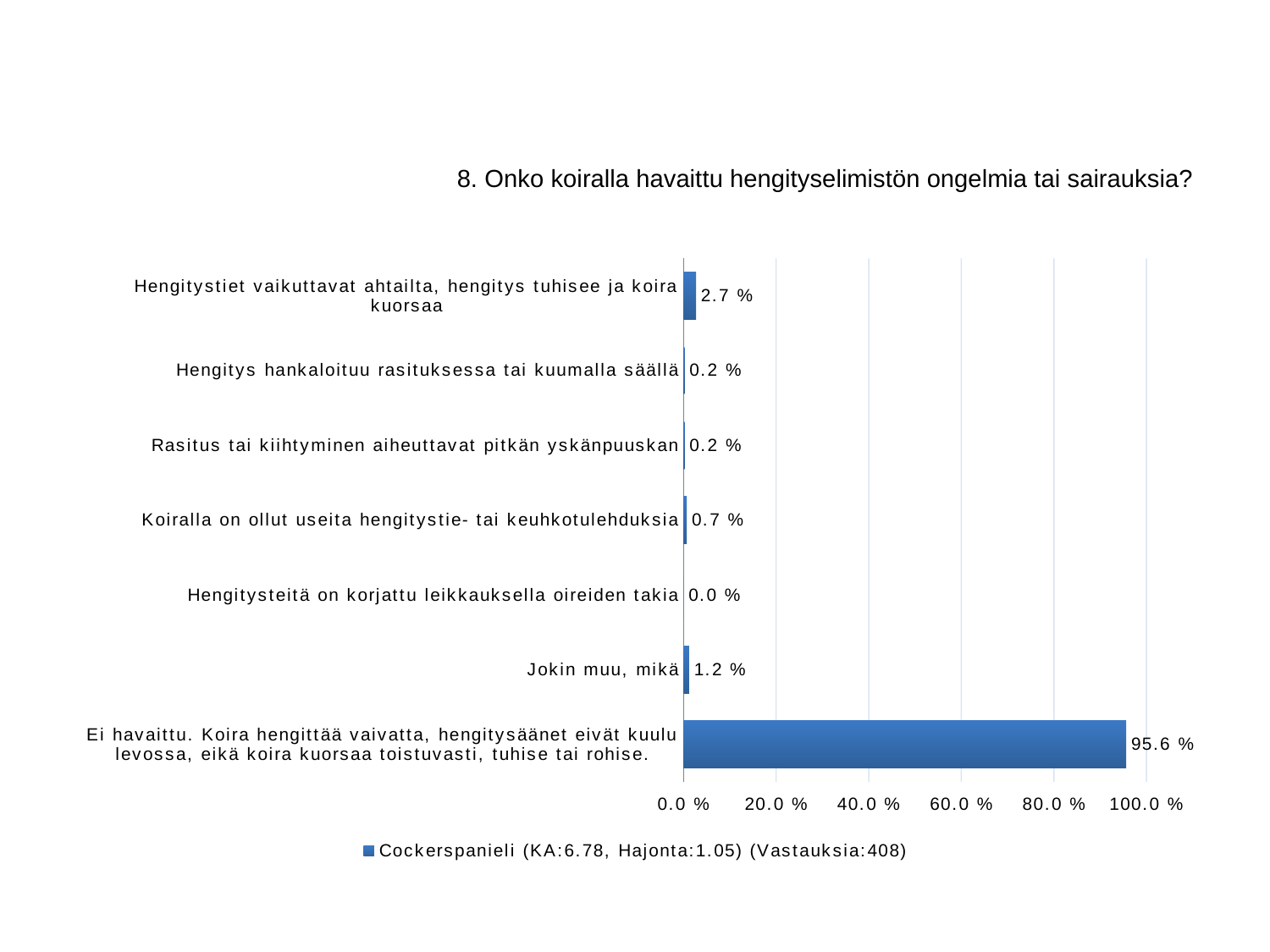
Which category has the highest value? Ei havaittu. Koira hengittää vaivatta, hengitysäänet eivät kuulu levossa, eikä koira kuorsaa toistuvasti, tuhise tai rohise. How many series does the legend list? 1 What is the value for "Hengitysteitä on korjattu leikkauksella oireiden takia"? 0.0 % Which category has the lowest value? Hengitysteitä on korjattu leikkauksella oireiden takia Which is larger: the value for "Jokin muu, mikä" or the value for "Koiralla on ollut useita hengitystie- tai keuhkotulehduksia"? Jokin muu, mikä What is the value for "Koiralla on ollut useita hengitystie- tai keuhkotulehduksia"? 0.7 % What is the value for "Jokin muu, mikä"? 1.2 % What is the value for "Hengitystiet vaikuttavat ahtailta, hengitys tuhisee ja koira kuorsaa"? 2.7 % How many categories are shown in the chart? 7 What kind of chart is shown on the slide? bar chart Is the value for "Ei havaittu. Koira hengittää vaivatta, hengitysäänet eivät kuulu levossa, eikä koira kuorsaa toistuvasti, tuhise tai rohise." greater or less than 80.0 %? greater What is the difference between the value for "Hengitystiet vaikuttavat ahtailta, hengitys tuhisee ja koira kuorsaa" and the value for "Jokin muu, mikä"? 1.5 %